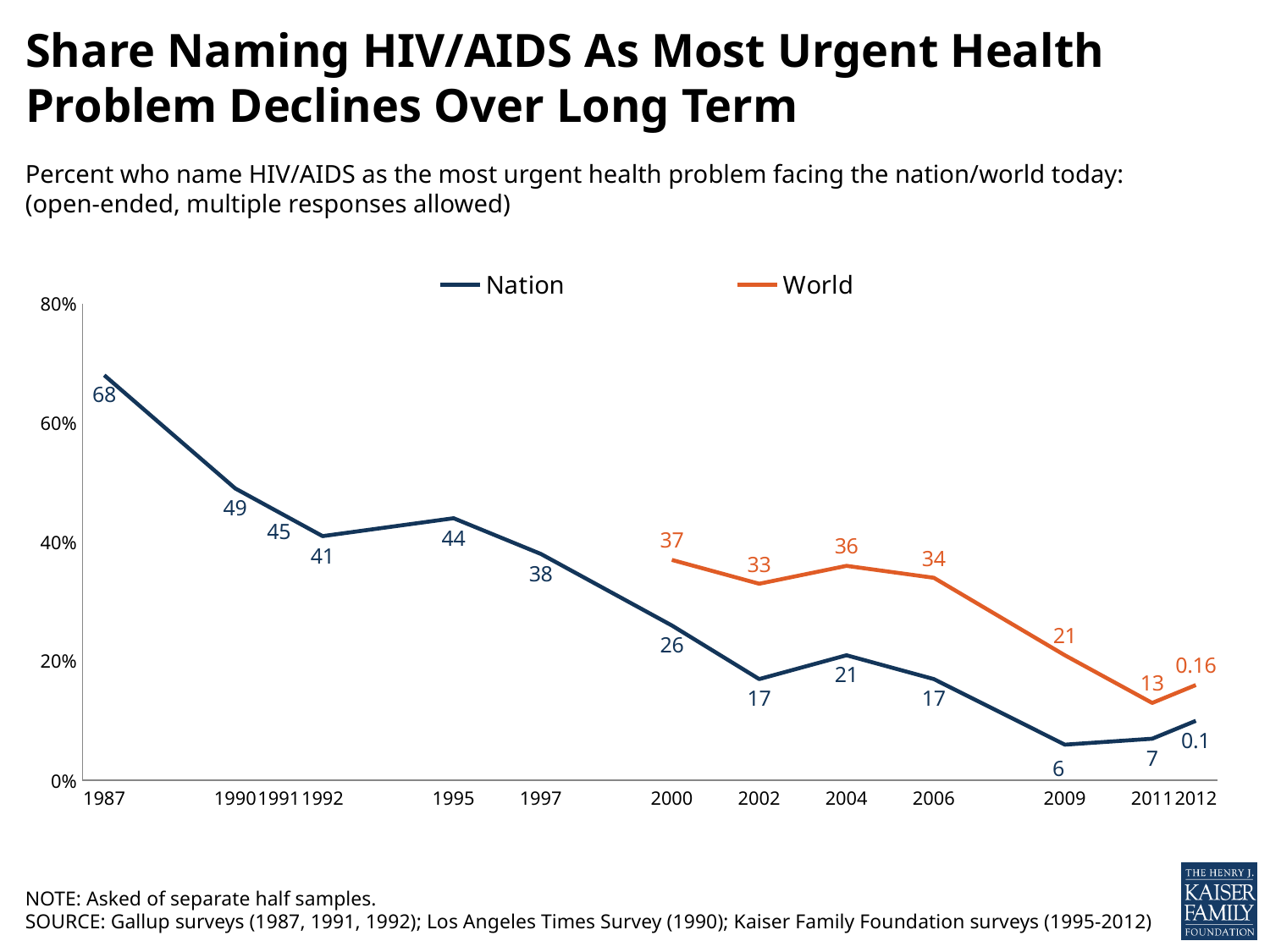
In which year is the World series at its lowest? 2011 What kind of chart is shown on the slide? Line chart What is the difference between the World and Nation values in 2002? 16 What is the value for World in 2000? 37 Which series is drawn in orange? World What is the value for World in 2011? 13 How many series does the legend list? 2 Which is larger in 2006, the Nation value or the World value? World In which year is the Nation series at its highest? 1987 What is the value for Nation in 1987? 68 Does the Nation series generally rise or fall from 1987 to 2012? Fall What is the value for Nation in 2009? 6